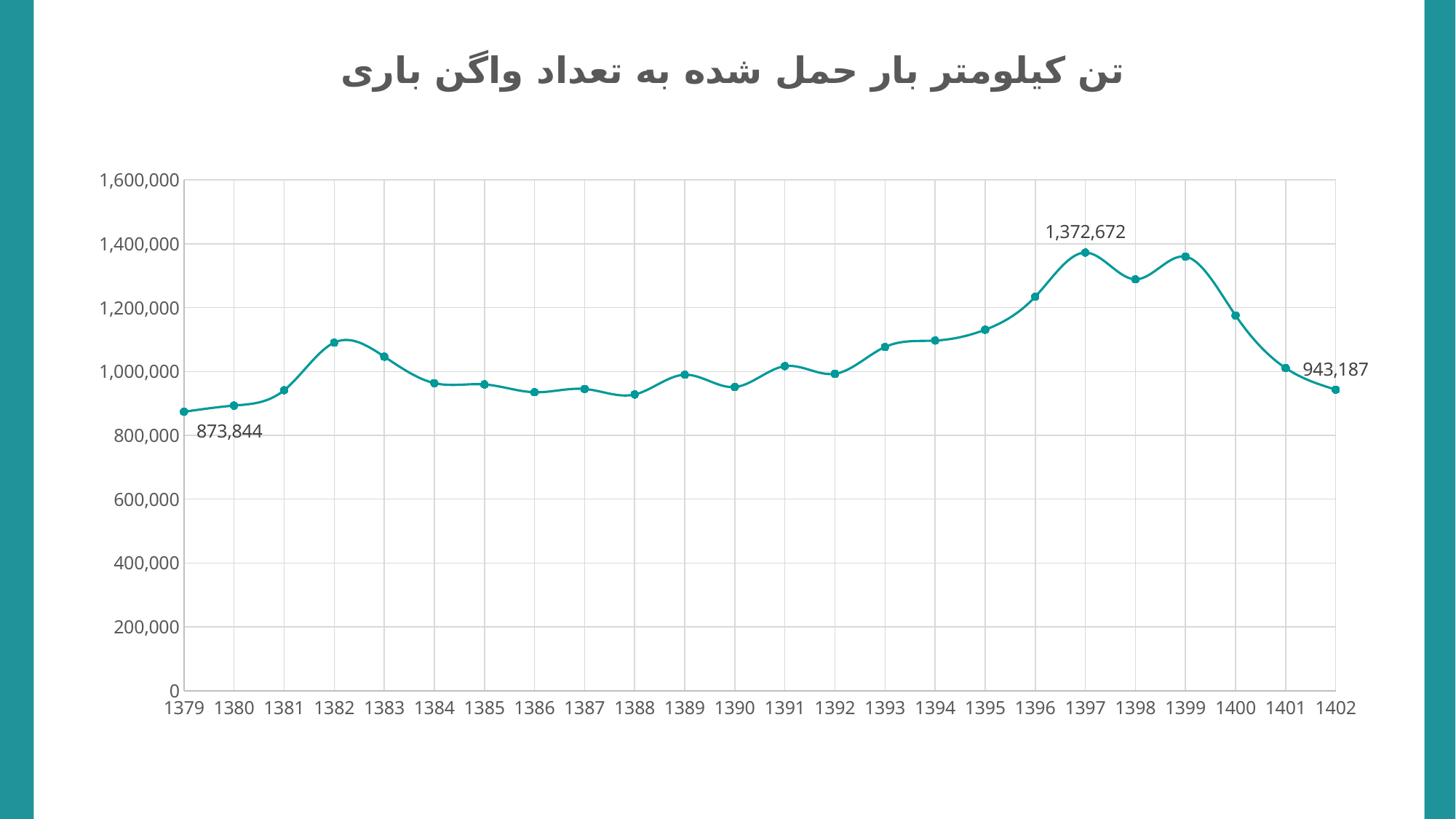
Is the value for 1396 greater or less than 1,200,000? greater What is the difference between the values for 1397 and 1379? 498,828 What is the value for 1397? 1,372,672 Which year has the highest value? 1397 What is the value for 1402? 943,187 Is the value for 1386 greater or less than 1,000,000? less Which is larger, the value for 1382 or the value for 1383? 1382 What kind of chart is shown on the slide? line chart What is the value for 1379? 873,844 How many years are plotted on the x axis? 24 Which year has the lowest value? 1379 What is the difference between the values for 1402 and 1379? 69,343